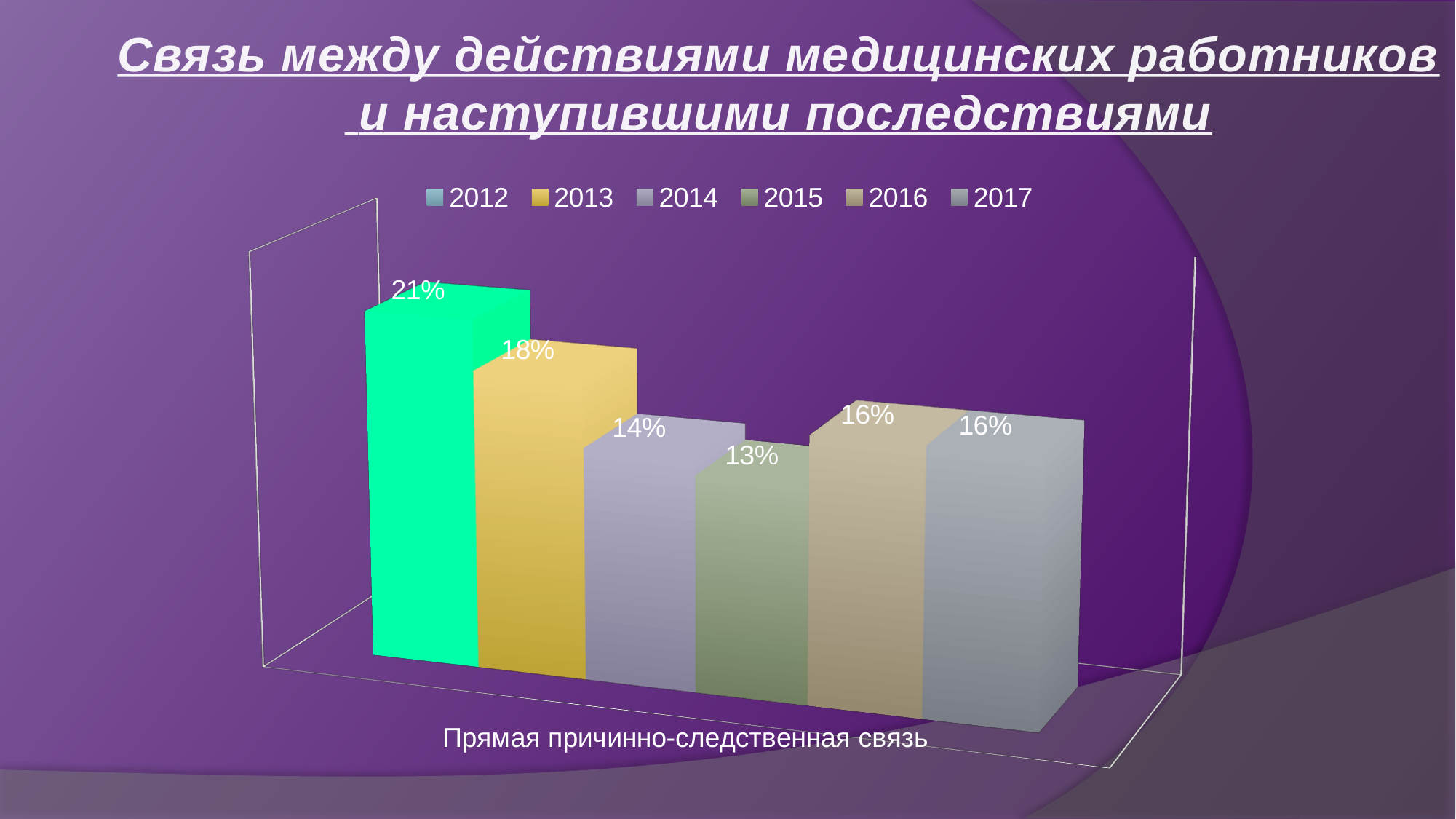
Which year has the lowest value in the chart? 2015 What is the difference between the values for 2012 and 2013? 3% What is the difference between the values for 2014 and 2016? 2% What is the value for 2015 in the chart? 13% How many series does the legend list? 6 What kind of chart is shown on the slide? Bar chart Which is larger, the value for 2013 or the value for 2016? 2013 What is the value for 2012 in the chart? 21% What is the category label shown below the bars? Прямая причинно-следственная связь Do the values rise or fall from 2012 to 2015? Fall Which year has the highest value in the chart? 2012 What is the value for 2017 in the chart? 16%